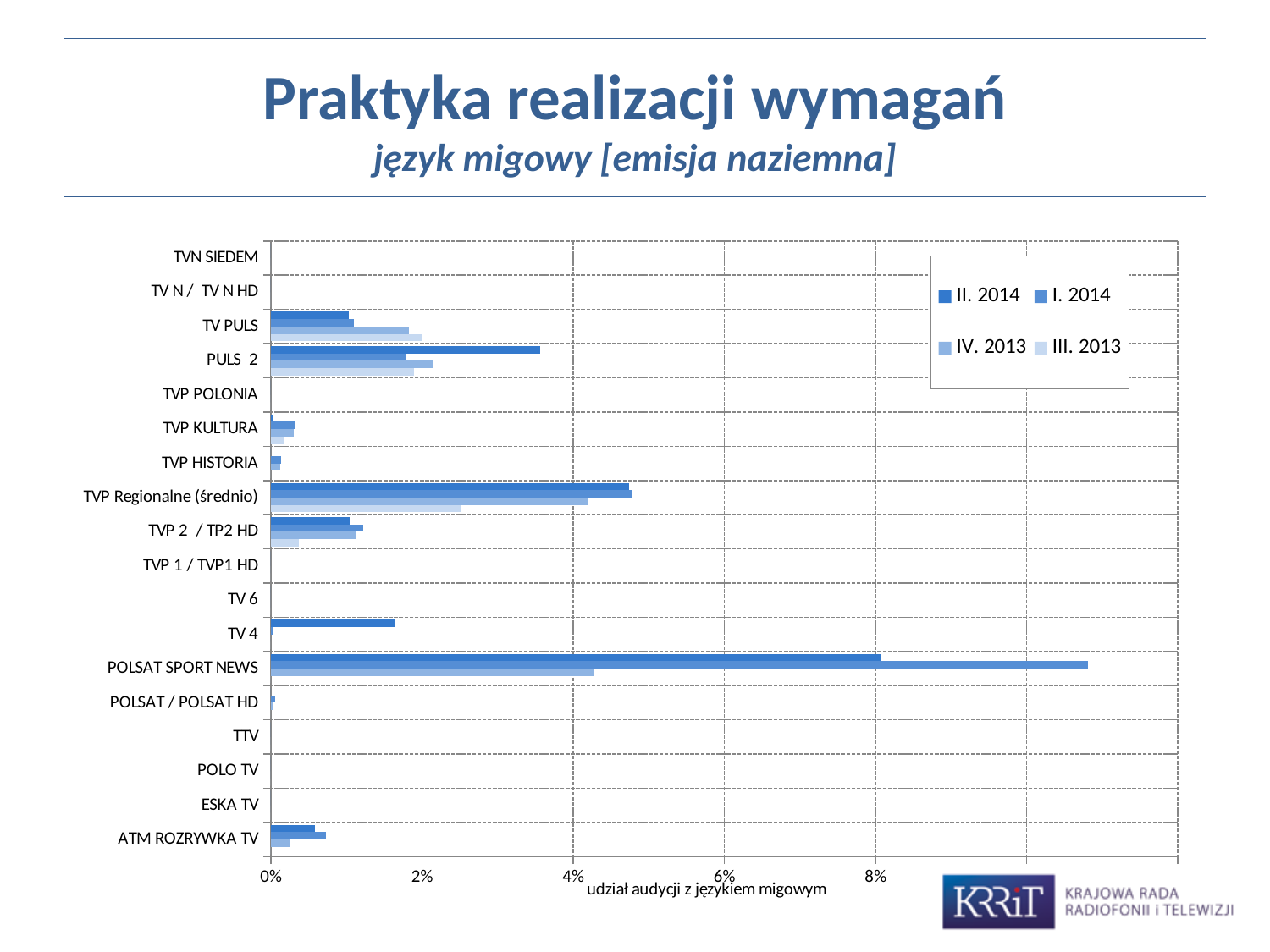
For the II. 2014 series, which is larger: POLSAT SPORT NEWS or TVP Regionalne (średnio)? POLSAT SPORT NEWS What is the title of the horizontal axis? udział audycji z językiem migowym Which series is listed first in the legend? II. 2014 For TV 4, which series has the larger value: II. 2014 or I. 2014? II. 2014 Is the I. 2014 value for POLSAT SPORT NEWS greater or less than 8%? greater How many broadcaster categories are listed on the vertical axis? 18 What kind of chart is shown on the slide? bar chart Is the II. 2014 value for TVP Regionalne (średnio) greater or less than 4%? greater Is the II. 2014 value for TV PULS greater or less than 2%? less How many series does the legend list? 4 Which broadcaster has the highest value for the I. 2014 series? POLSAT SPORT NEWS